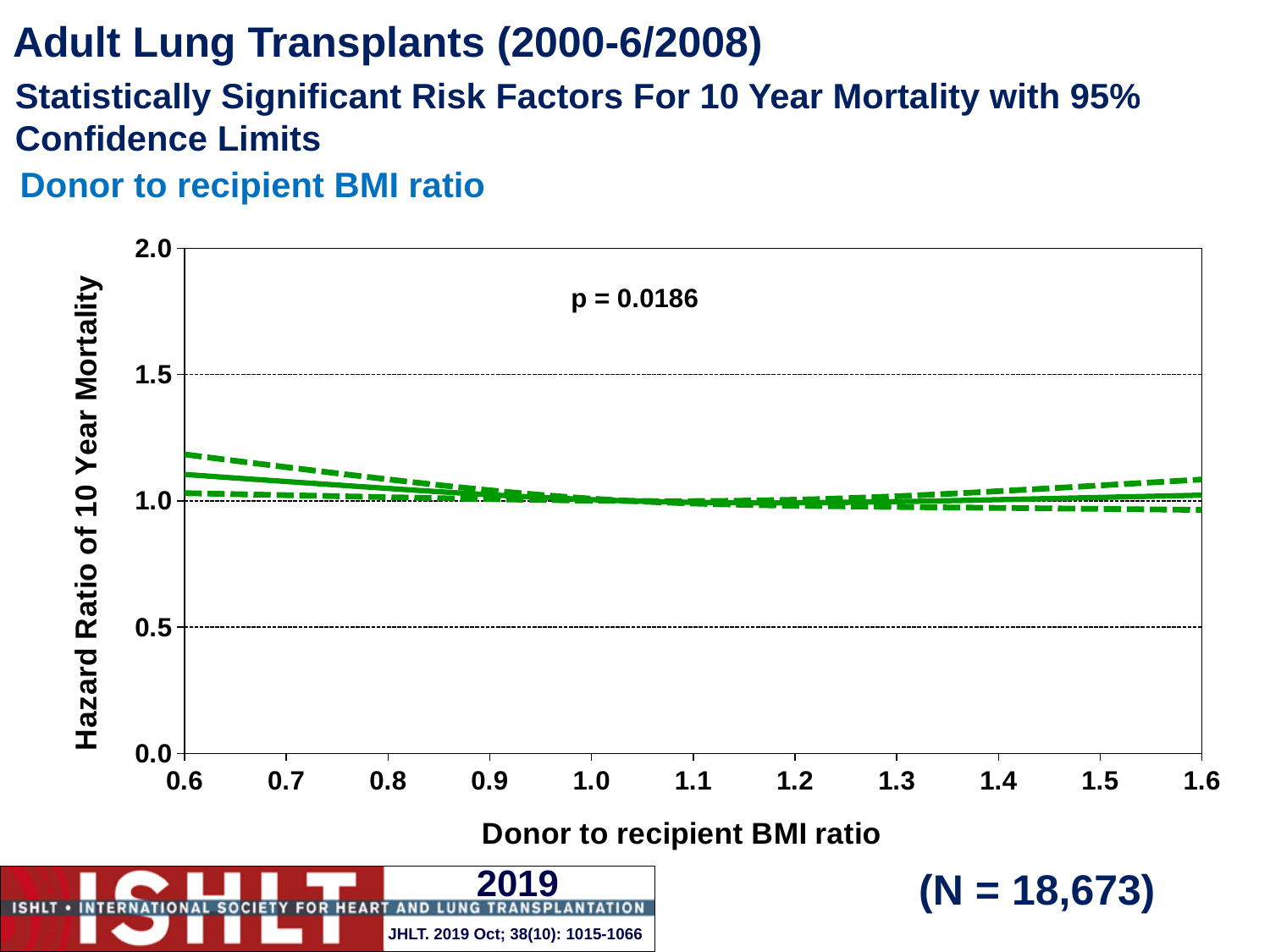
Is the upper confidence limit at a donor to recipient BMI ratio of 0.6 greater or less than 1.5? less Is the hazard ratio (solid line) at a donor to recipient BMI ratio of 0.6 greater or less than 1.0? greater What is the label of the x axis? Donor to recipient BMI ratio What p-value is printed on the chart? p = 0.0186 Is the hazard ratio (solid line) at a donor to recipient BMI ratio of 1.0 greater or less than 1.5? less What kind of chart is shown on the slide? line chart What is the sample size N shown on the slide? N = 18,673 Does the hazard ratio (solid line) rise or fall as the donor to recipient BMI ratio increases from 0.6 to 1.0? fall What is the range of the x axis? 0.6 to 1.6 How many lines are plotted on the chart? 3 What is the highest value shown on the y axis? 2.0 What is the label of the y axis? Hazard Ratio of 10 Year Mortality